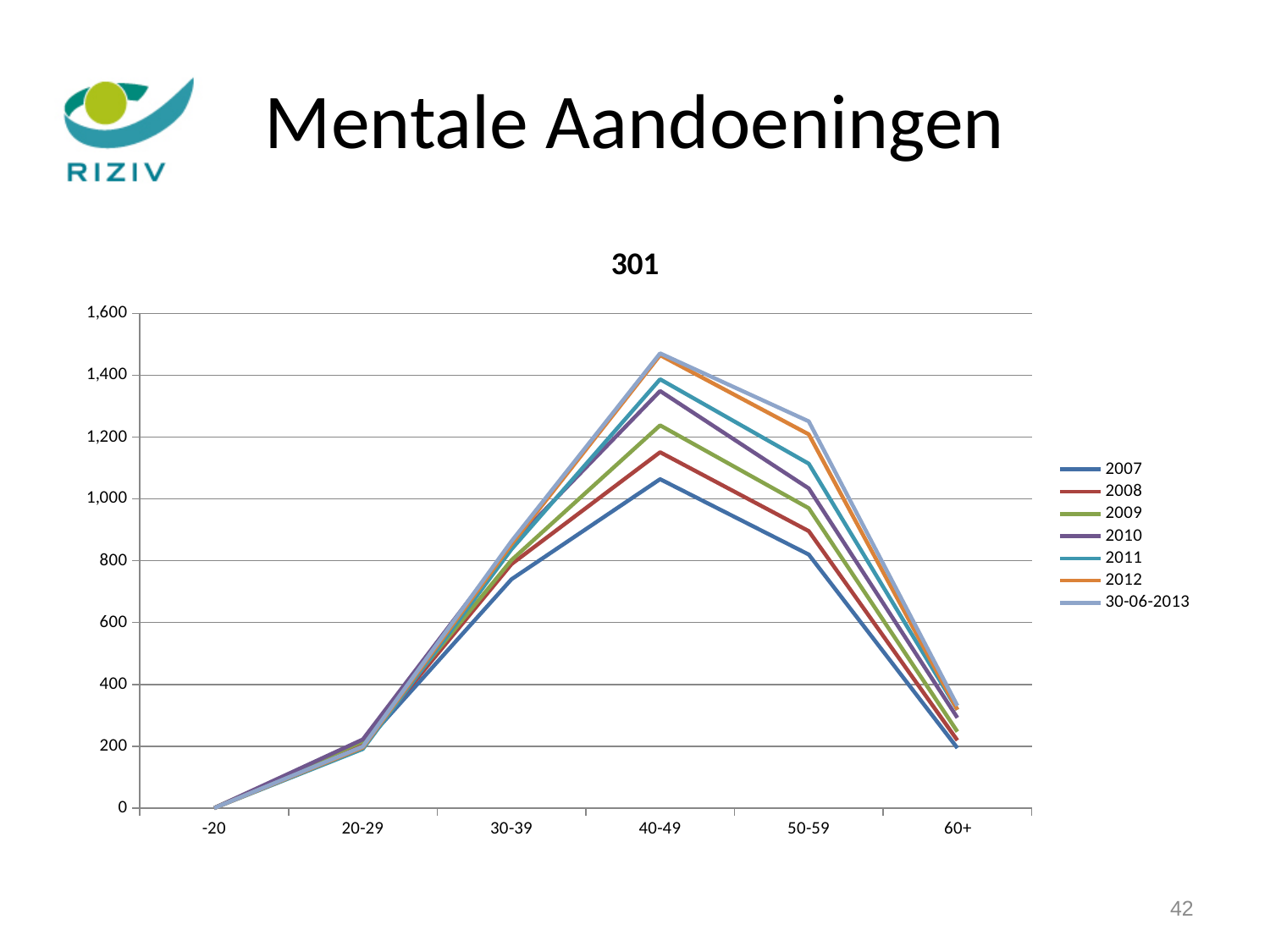
How many series does the legend list? 7 Which age category has the lowest value for the 2012 series? -20 For the 2007 series, do the values rise or fall from 40-49 to 60+? fall Which series has the lowest value at the 40-49 category? 2007 What kind of chart is shown on the slide? line chart Is the value for 2007 at 40-49 greater or less than 1,000? greater What is the title of the chart? 301 At the 40-49 category, which is larger: the value for 2012 or the value for 2007? 2012 Which age category has the highest value for the 2007 series? 40-49 Is the value for 2008 at 50-59 greater or less than 1,000? less How many age categories are shown on the x axis? 6 Is the value for 2007 at 30-39 greater or less than 800? less